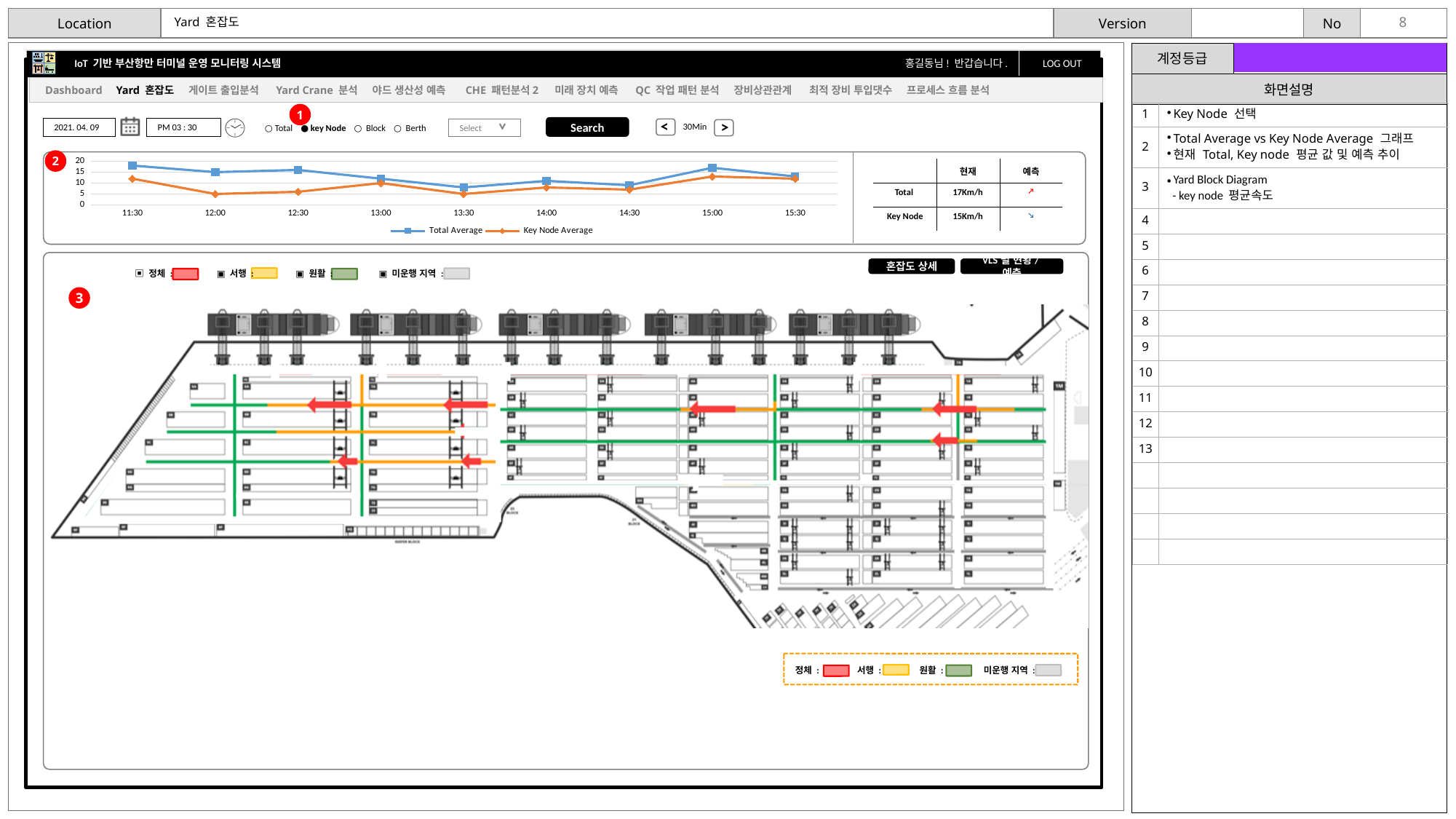
Is the Key Node Average value at 12:00 greater or less than 10? less Is the Key Node Average value at 15:00 greater or less than 10? greater Does the Key Node Average line rise or fall from 14:30 to 15:00? rise Is the Total Average value at 11:30 greater or less than 15? greater How many series does the legend of the line chart list? 2 What kind of chart is shown in the Total Average vs Key Node Average panel? line chart How many time points are plotted along the x axis of the line chart? 9 At 11:30, which series has the larger value, Total Average or Key Node Average? Total Average What colour is the Key Node Average line in the chart? orange Does the Total Average line rise or fall from 11:30 to 13:30? fall At 12:00, which series has the larger value, Total Average or Key Node Average? Total Average